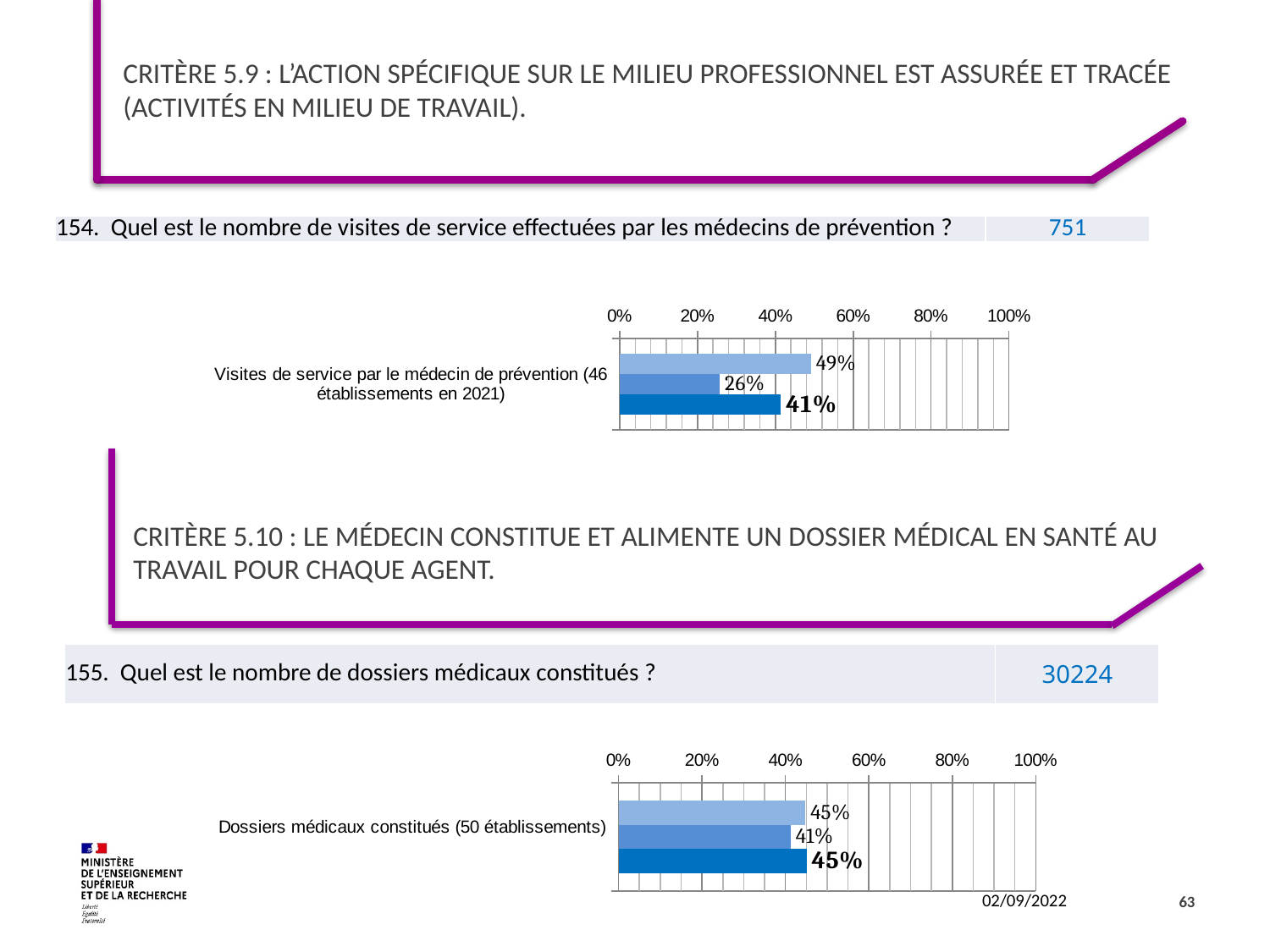
In the bottom chart (Dossiers médicaux constitués), what value is shown on the bottom bar? 45% In the top chart (Visites de service par le médecin de prévention), how many bars are plotted? 3 In the top chart (Visites de service par le médecin de prévention), what value is shown on the top bar? 49% In the bottom chart (Dossiers médicaux constitués), what is the difference between the top bar and the middle bar? 4% In the top chart (Visites de service par le médecin de prévention), what value is shown on the bottom bar? 41% In the bottom chart (Dossiers médicaux constitués), is the value of the middle bar greater or less than 60%? less In the bottom chart (Dossiers médicaux constitués), what value is shown on the middle bar? 41% In the top chart (Visites de service par le médecin de prévention), what is the difference between the top bar and the middle bar? 23% What is the highest value shown on the x axis of the top chart (Visites de service par le médecin de prévention)? 100% In the top chart (Visites de service par le médecin de prévention), which bar has the lowest value: top, middle or bottom? middle What kind of chart is the bottom chart (Dossiers médicaux constitués)? bar chart In the top chart (Visites de service par le médecin de prévention), what value is shown on the middle bar? 26%